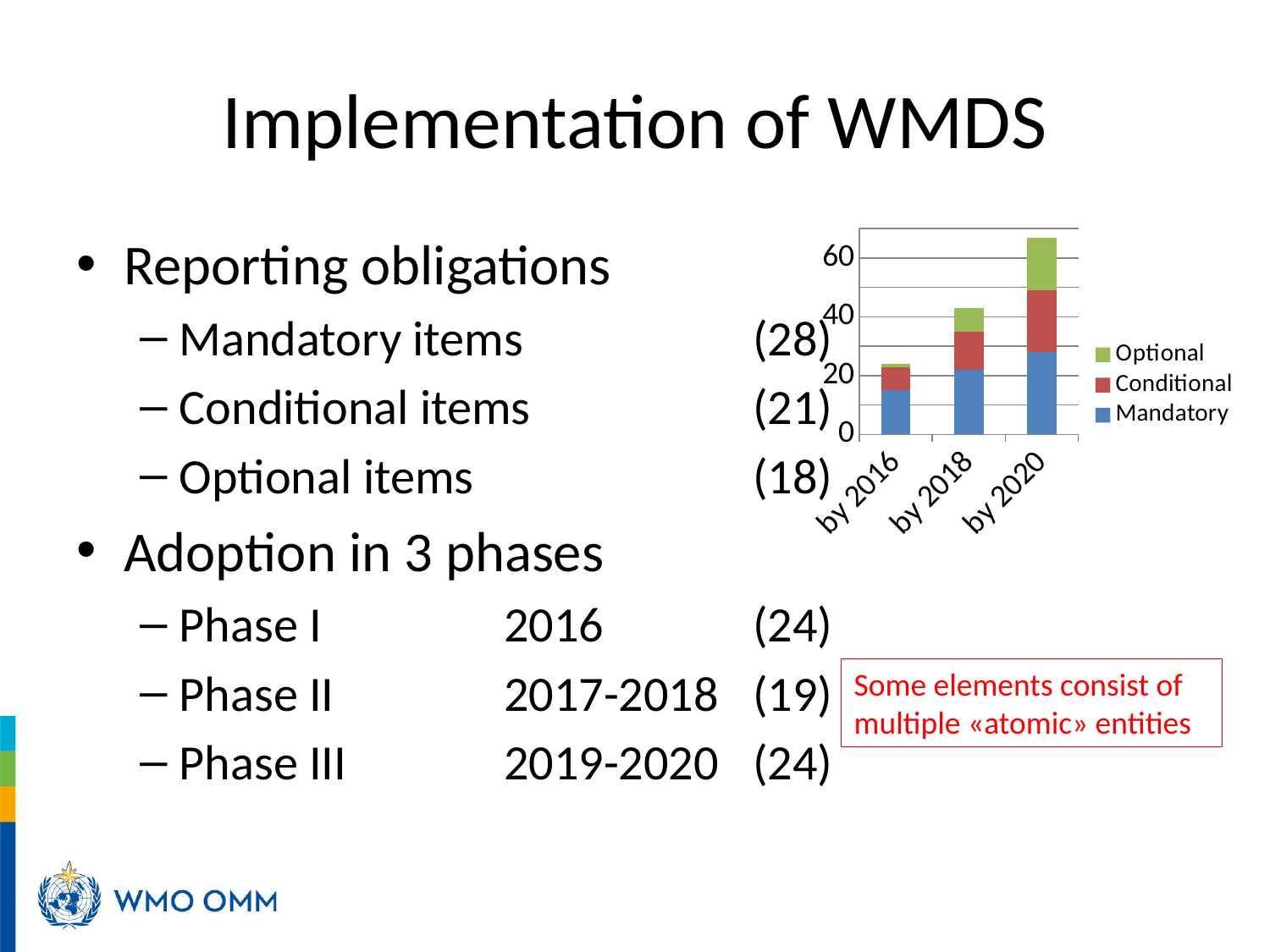
Is the Mandatory value for 'by 2016' greater or less than 20? less Which category has the tallest stacked bar in the chart? by 2020 Do the stacked bar totals rise or fall from 'by 2016' to 'by 2020'? rise Which series forms the bottom segment of each stacked bar? Mandatory How many series does the chart legend list? 3 How many categories are shown along the x axis of the chart? 3 Is the total height of the 'by 2020' bar greater or less than 60? greater What kind of chart is shown on the slide? stacked bar chart Is the Mandatory value for 'by 2020' greater or less than 20? greater Which series is shown in green in the chart legend? Optional Which category has the shortest stacked bar in the chart? by 2016